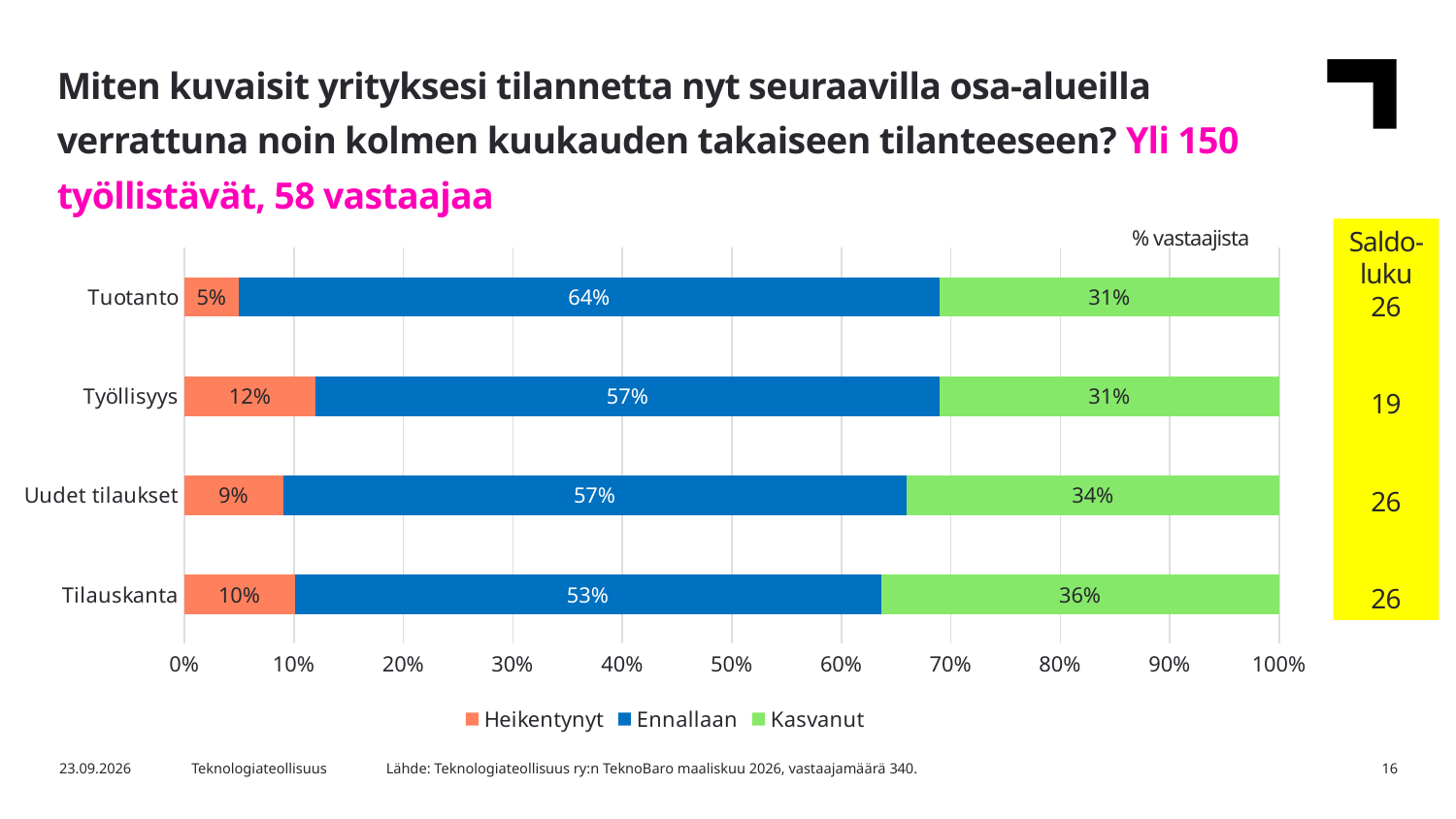
What percentage of respondents answered "Ennallaan" for Tuotanto? 64% What is the "Kasvanut" value for Tilauskanta? 36% Which is larger: the "Kasvanut" share for Uudet tilaukset or for Työllisyys? Uudet tilaukset Which category has the lowest "Heikentynyt" share? Tuotanto What is the "Heikentynyt" value for Työllisyys? 12% What kind of chart is shown on the slide? Stacked horizontal bar chart What is the difference between the "Ennallaan" values for Tuotanto and Tilauskanta? 11 percentage points How many categories are shown on the y axis of the chart? 4 Which category has the highest "Kasvanut" share? Tilauskanta Which series is shown in green in the legend? Kasvanut What is the total of the stacked bar for Uudet tilaukset? 100% How many series does the legend list? 3